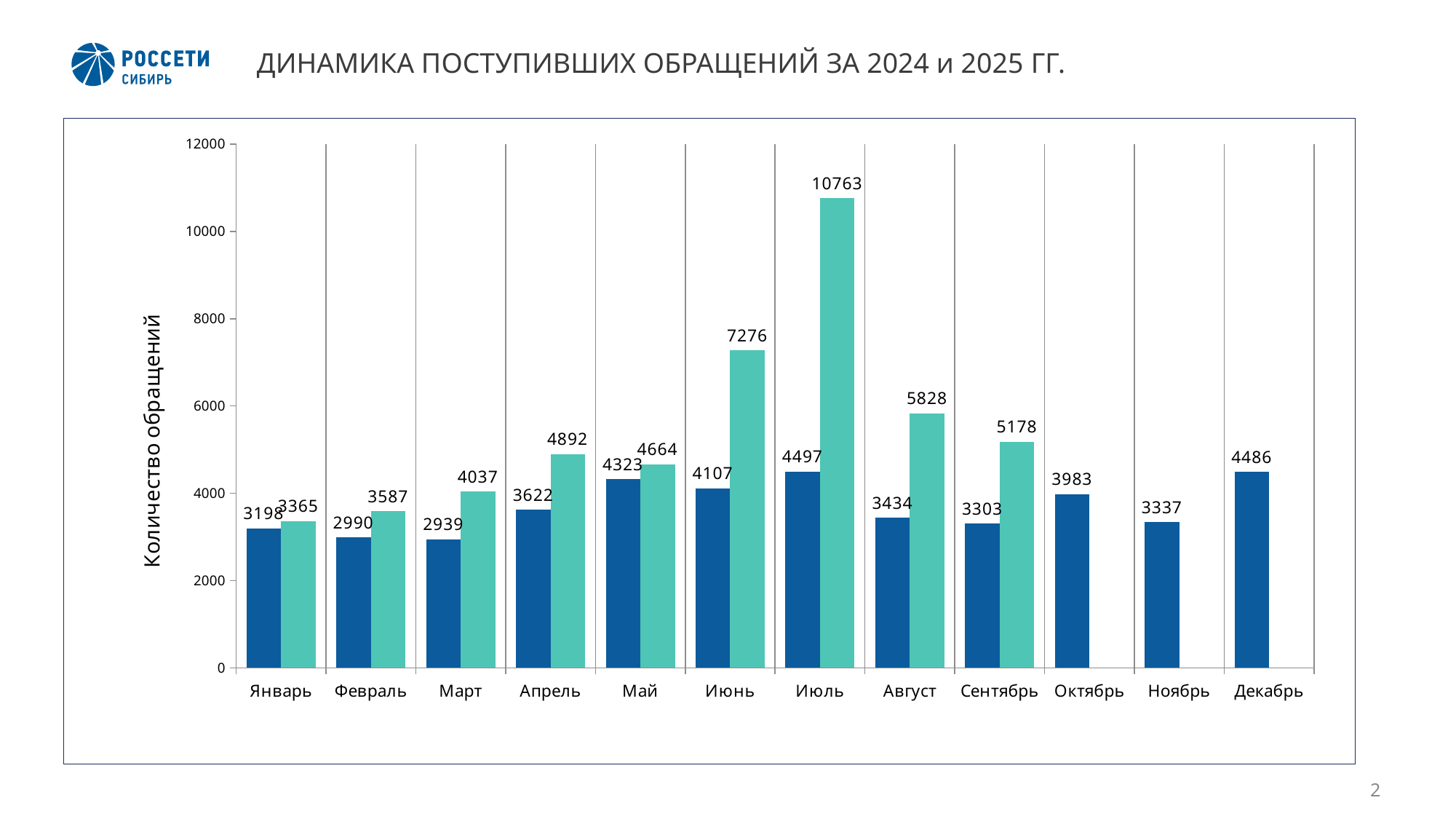
What is the difference between the teal bar and the dark blue bar for Август? 2394 In which month is the teal bar the highest? Июль What kind of chart is shown on the slide? bar chart For Май, which is larger: the dark blue bar or the teal bar? the teal bar How many months are shown on the x axis? 12 What is the value of the dark blue bar for Декабрь? 4486 What is the difference between the teal bar and the dark blue bar for Июль? 6266 Do the dark blue bars rise or fall from Январь to Март? fall How many months have a teal bar? 9 What is the value of the teal bar for Сентябрь? 5178 What is the value of the teal bar for Июль? 10763 In which month is the dark blue bar the lowest? Март